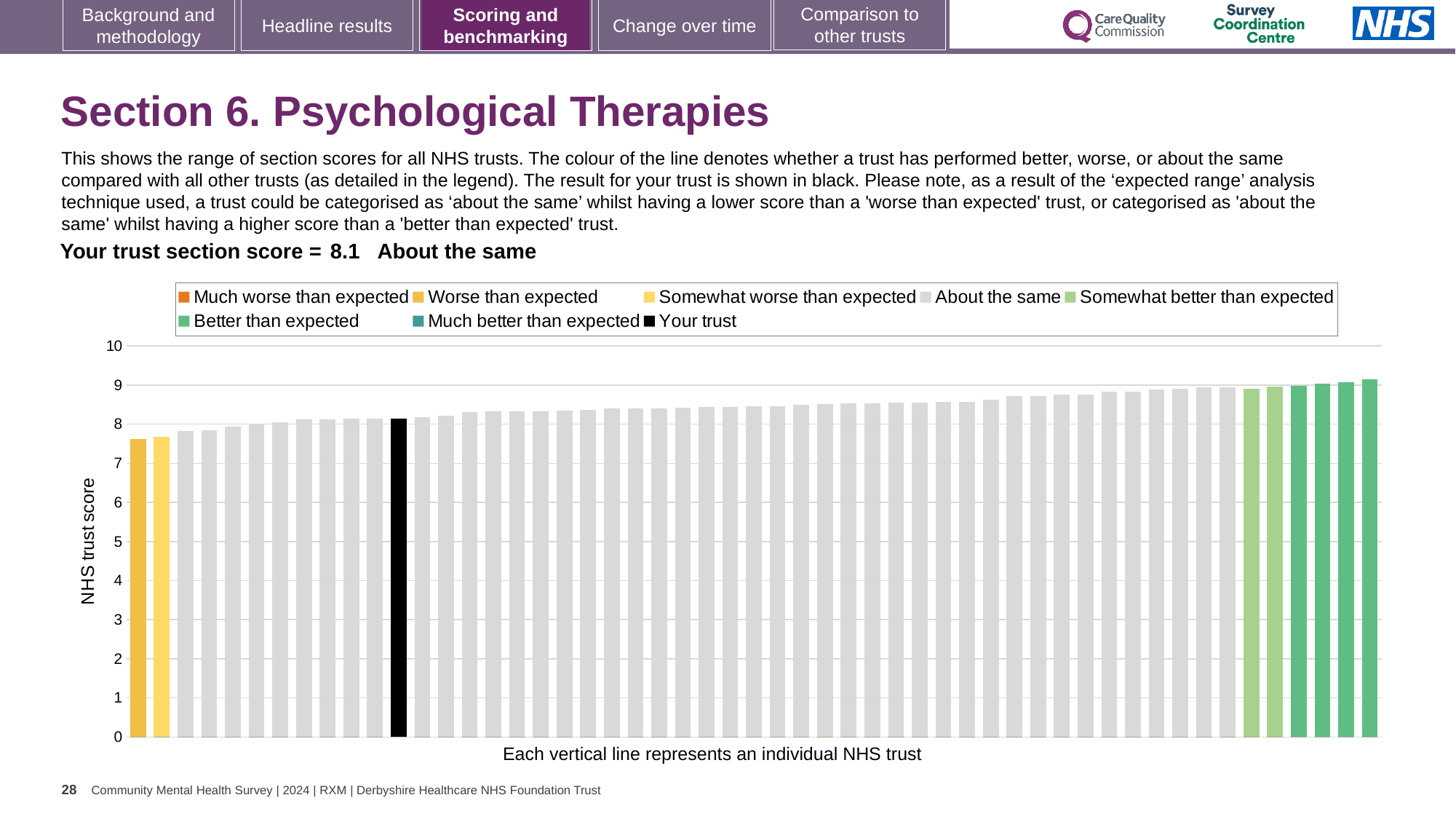
Is the value of the lowest bar in the chart greater or less than 8? less Is the value of the lowest bar in the chart greater or less than 7? greater Is the value of the highest bar in the chart greater or less than 9? greater Do the bar values rise or fall from left to right along the x axis? rise Is the leftmost bar higher or lower than the black bar for your trust? lower What kind of chart is shown on the slide? bar chart How many bars are coloured as 'Worse than expected'? 1 How many entries does the chart legend list? 8 What is the section score for your trust shown on the slide? 8.1 What is the label on the vertical axis of the chart? NHS trust score Which category is your trust's section score placed in? About the same